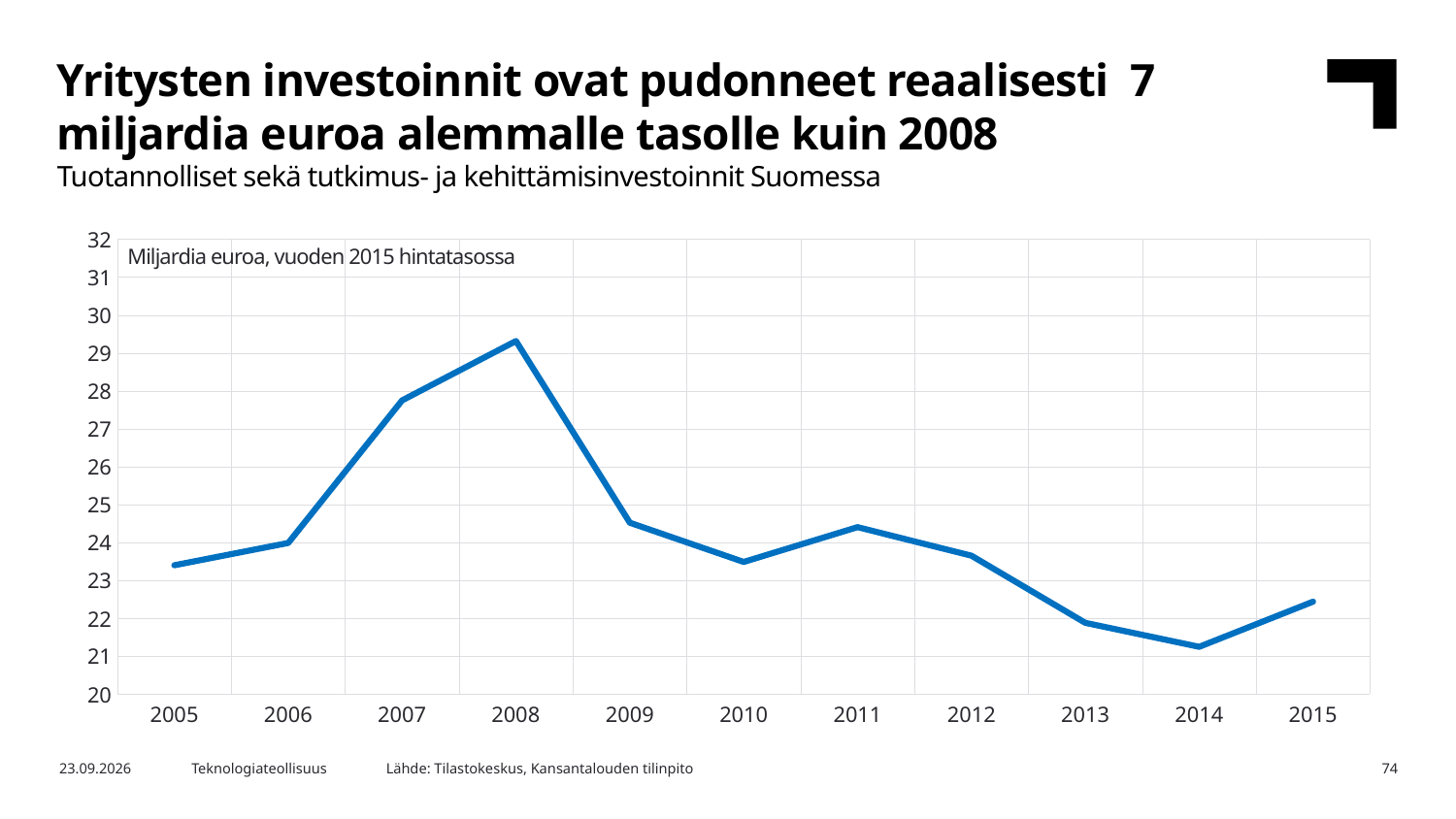
Do the values rise or fall from 2008 to 2010? fall Is the value for 2009 greater or less than 25? less Which year has the larger value, 2007 or 2010? 2007 Is the value for 2007 greater or less than 27? greater Is the value for 2014 greater or less than 22? less How many years are plotted on the x axis? 11 Which year has the highest value of investments? 2008 What kind of chart is shown on the slide? line chart Which year has the lowest value of investments? 2014 In what unit are the values expressed, according to the label inside the chart? Miljardia euroa, vuoden 2015 hintatasossa